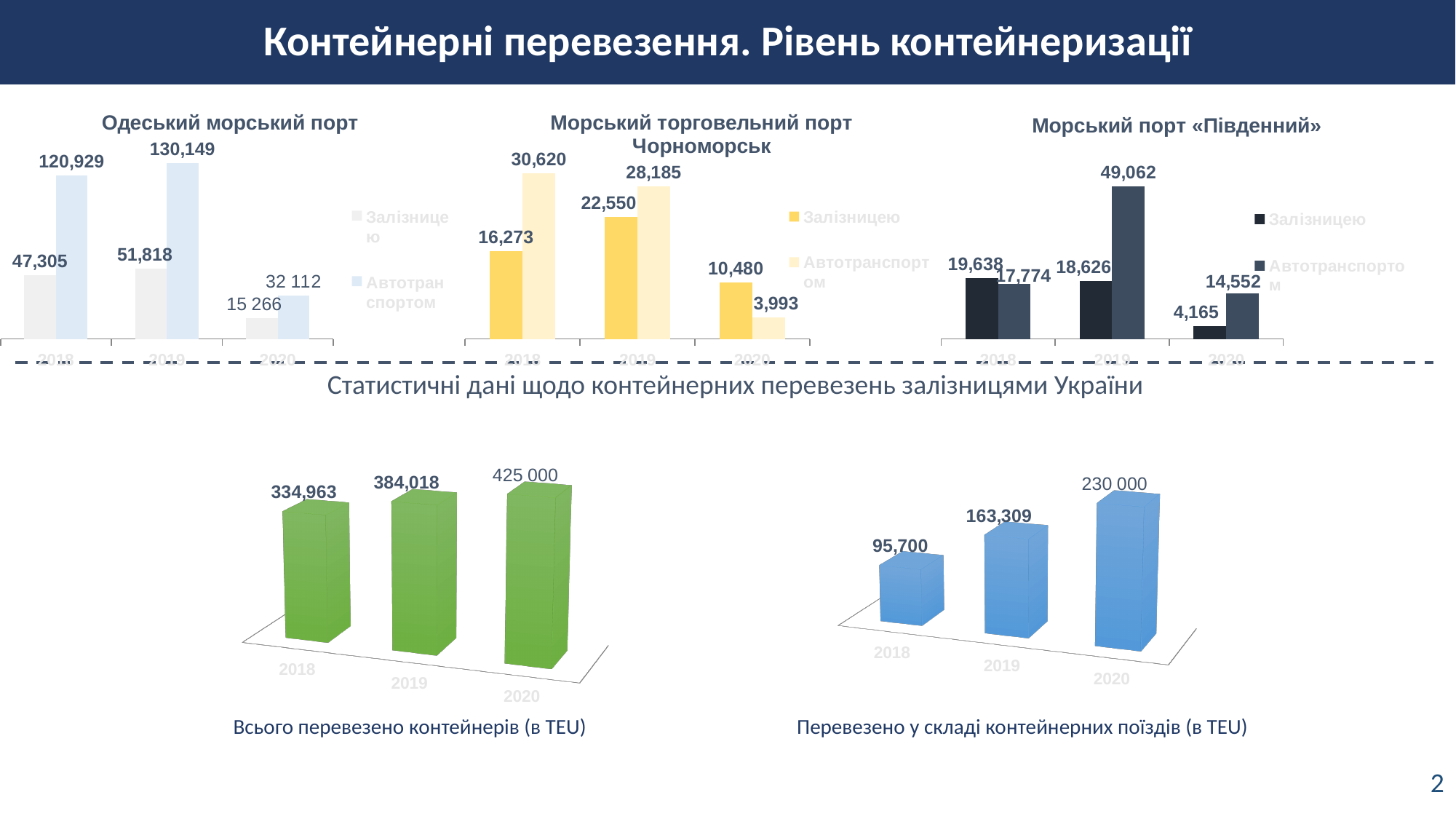
In the chart titled "Перевезено у складі контейнерних поїздів (в TEU)", what is the difference between 2019 and 2018? 67,609 In the chart titled "Одеський морський порт", what is the value for Автотранспортом in 2019? 130,149 In the chart titled "Перевезено у складі контейнерних поїздів (в TEU)", which year has the lowest value? 2018 In the chart titled "Морський порт «Південний»", what is the difference between Залізницею and Автотранспортом in 2018? 1,864 In the chart titled "Морський порт «Південний»", what is the value for Автотранспортом in 2019? 49,062 In the chart titled "Морський порт «Південний»", how many series does the legend list? 2 In the chart titled "Морський торговельний порт Чорноморськ", what is the value for Залізницею in 2019? 22,550 In the chart titled "Всього перевезено контейнерів (в TEU)", what is the value for 2019? 384,018 In the chart titled "Одеський морський порт", what is the value for Залізницею in 2020? 15 266 In the chart titled "Всього перевезено контейнерів (в TEU)", do the values rise or fall from 2018 to 2020? rise In the chart titled "Морський торговельний порт Чорноморськ", which is larger in 2020, Залізницею or Автотранспортом? Залізницею What kind of chart is the one titled "Перевезено у складі контейнерних поїздів (в TEU)"? bar chart